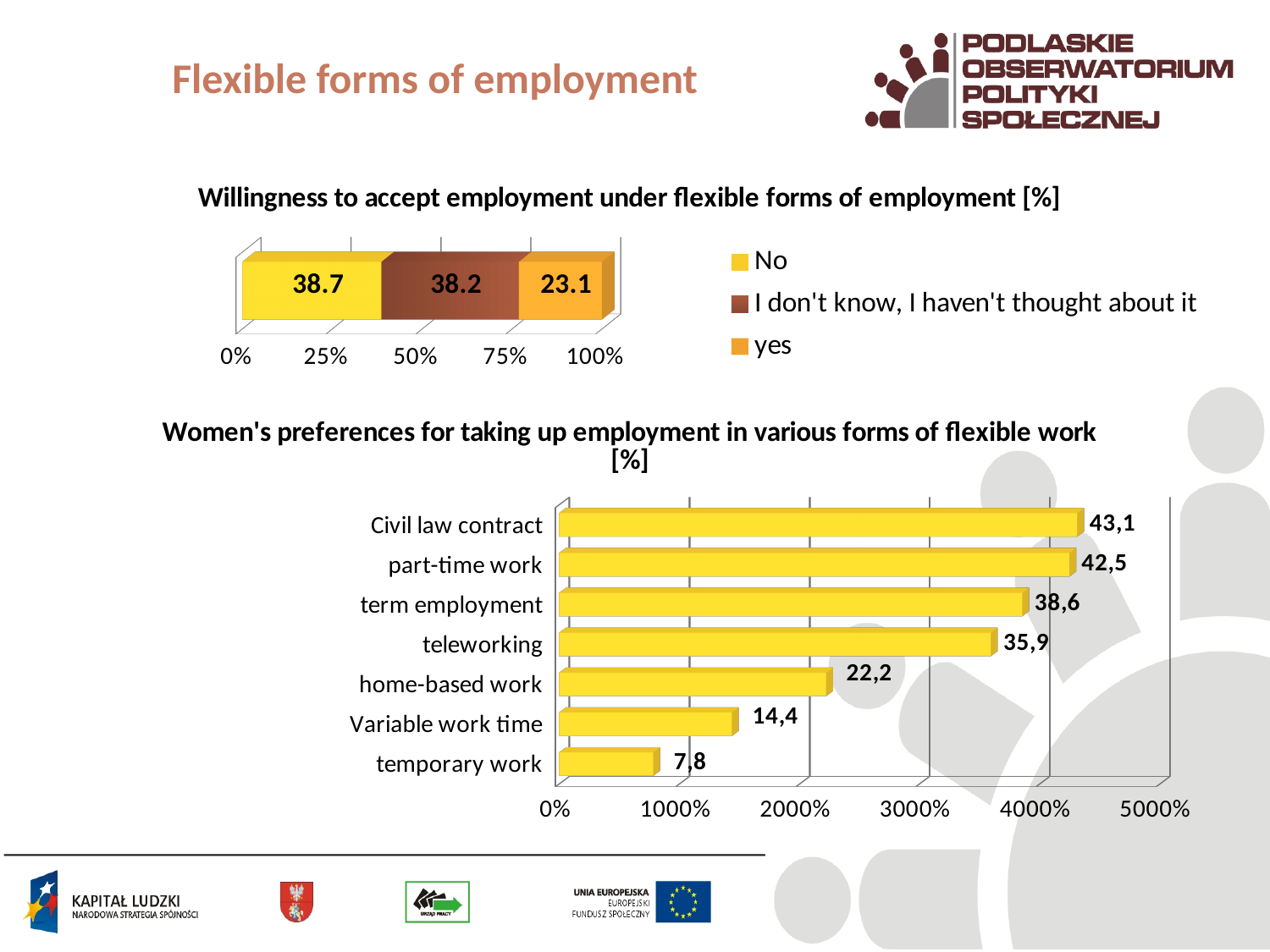
In the 'Willingness to accept employment under flexible forms of employment [%]' chart, what is the total of the stacked bar? 100 In the 'Women's preferences for taking up employment in various forms of flexible work [%]' chart, how many categories are shown? 7 In the 'Women's preferences for taking up employment in various forms of flexible work [%]' chart, what is the value for 'home-based work'? 22,2 In the 'Women's preferences for taking up employment in various forms of flexible work [%]' chart, what is the difference between 'term employment' and 'Variable work time'? 24,2 In the 'Willingness to accept employment under flexible forms of employment [%]' chart, what is the value for 'No'? 38.7 In the 'Women's preferences for taking up employment in various forms of flexible work [%]' chart, what is the value for 'teleworking'? 35,9 In the 'Willingness to accept employment under flexible forms of employment [%]' chart, how many series does the legend list? 3 What kind of chart is the 'Women's preferences for taking up employment in various forms of flexible work [%]' chart? bar chart In the 'Women's preferences for taking up employment in various forms of flexible work [%]' chart, which category has the lowest value? temporary work In the 'Willingness to accept employment under flexible forms of employment [%]' chart, what is the value for 'yes'? 23.1 In the 'Women's preferences for taking up employment in various forms of flexible work [%]' chart, which category has the highest value? Civil law contract In the 'Willingness to accept employment under flexible forms of employment [%]' chart, which legend entry is shown in brown? I don't know, I haven't thought about it